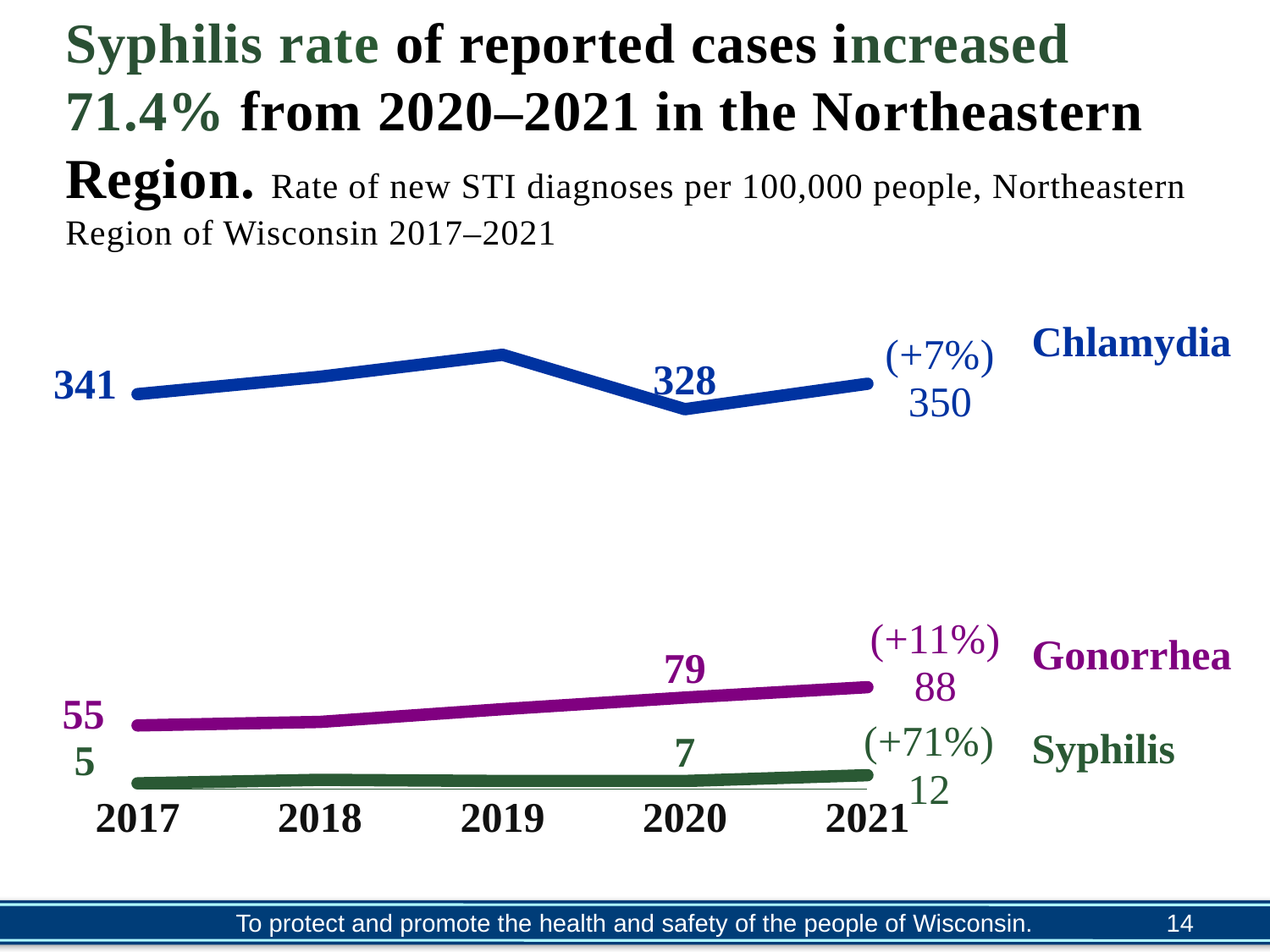
What was the gonorrhea rate in 2020? 79 Which was larger, the chlamydia rate in 2020 or in 2021? 2021 By how much did the gonorrhea rate increase from 2017 to 2021? 33 What percentage change is shown for syphilis from 2020 to 2021? +71% How many STIs are plotted on the chart? 3 Which STI had the lowest rate in 2017? Syphilis Which STI had the highest rate in 2021? Chlamydia What type of chart is shown on the slide? Line chart What was the chlamydia rate in 2017? 341 How many years are shown on the x axis? 5 What was the chlamydia rate in 2021? 350 What was the syphilis rate in 2021? 12